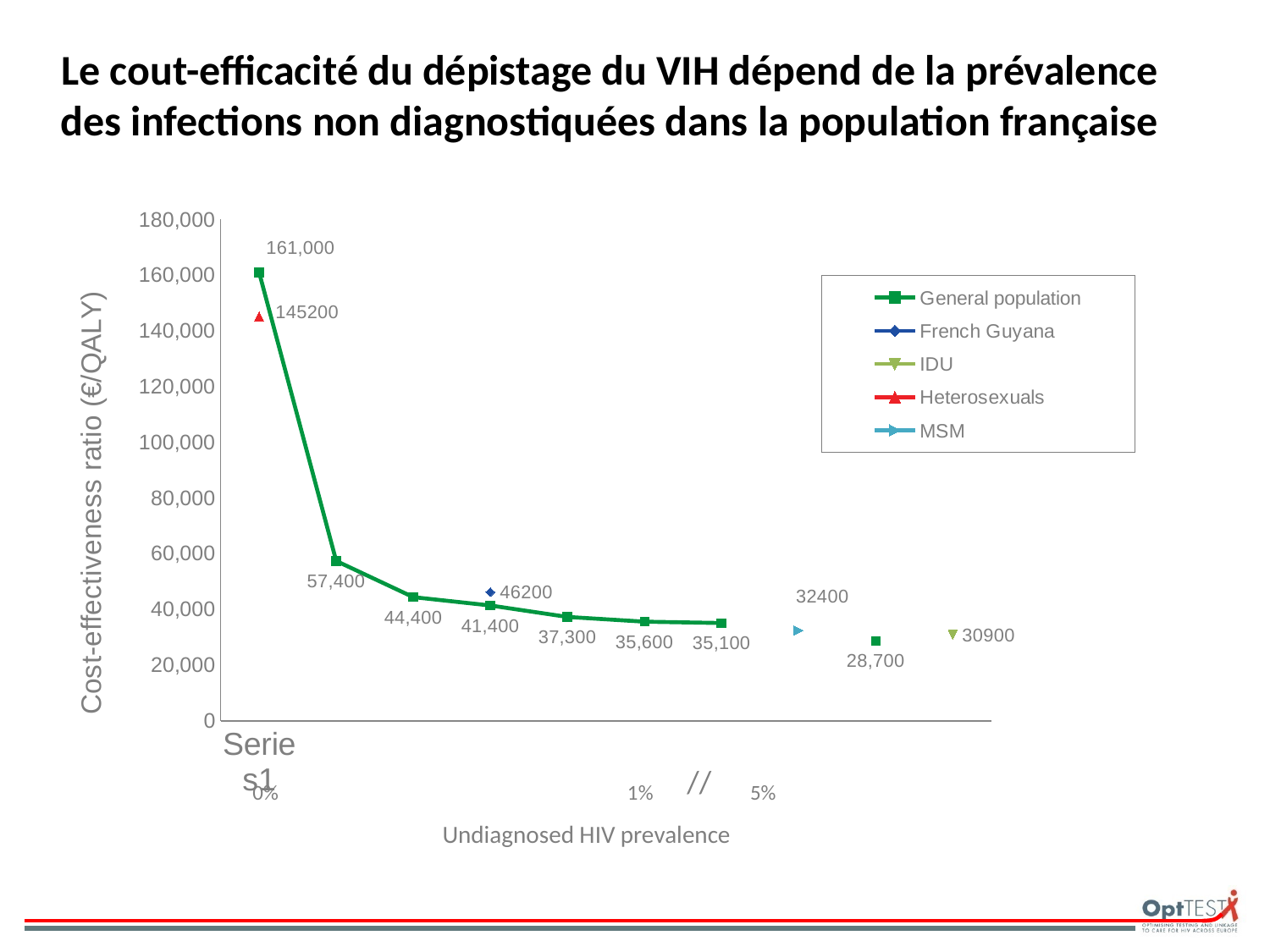
How many series does the chart legend list? 5 What is the title of the vertical axis? Cost-effectiveness ratio (€/QALY) What kind of chart is shown on the slide? line chart Which has the larger cost-effectiveness ratio, French Guyana or MSM? French Guyana What is the cost-effectiveness ratio shown for MSM? 32400 What is the cost-effectiveness ratio shown for Heterosexuals? 145200 What is the cost-effectiveness ratio shown for IDU? 30900 What is the lowest labelled value for the General population series? 28,700 What is the highest labelled value on the General population line? 161,000 Does the General population line rise or fall as undiagnosed HIV prevalence increases? fall What is the difference between the first two labelled General population values, 161,000 and 57,400? 103,600 What is the cost-effectiveness ratio shown for French Guyana? 46200